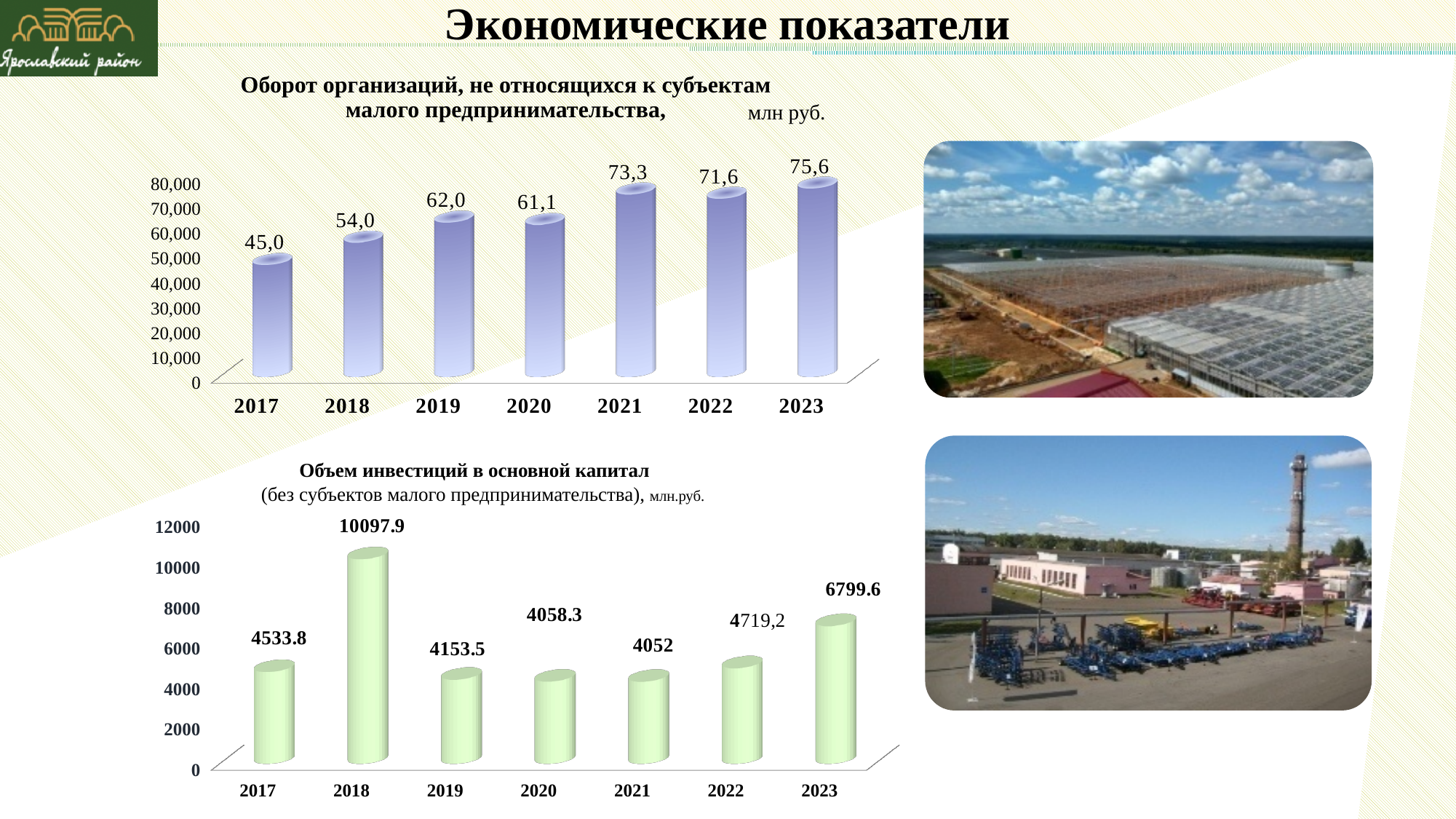
In the top chart (Оборот организаций), which is larger: the value for 2021 or the value for 2022? 2021 What type of chart is the bottom chart (Объем инвестиций в основной капитал)? Bar chart In the top chart (Оборот организаций), how many years are shown on the x axis? 7 In the bottom chart (Объем инвестиций в основной капитал), what is the value for 2023? 6799.6 In the bottom chart (Объем инвестиций в основной капитал), which is larger: the value for 2017 or the value for 2019? 2017 In the top chart (Оборот организаций), which year has the highest value? 2023 In the bottom chart (Объем инвестиций в основной капитал), what is the value for 2018? 10097.9 In the bottom chart (Объем инвестиций в основной капитал), which year has the highest value? 2018 In the top chart (Оборот организаций), what is the difference between the 2023 value and the 2017 value? 30,6 In the bottom chart (Объем инвестиций в основной капитал), what is the difference between the 2018 value and the 2017 value? 5564.1 In the top chart (Оборот организаций), which year has the lowest value? 2017 In the top chart (Оборот организаций), what is the value for 2021? 73,3